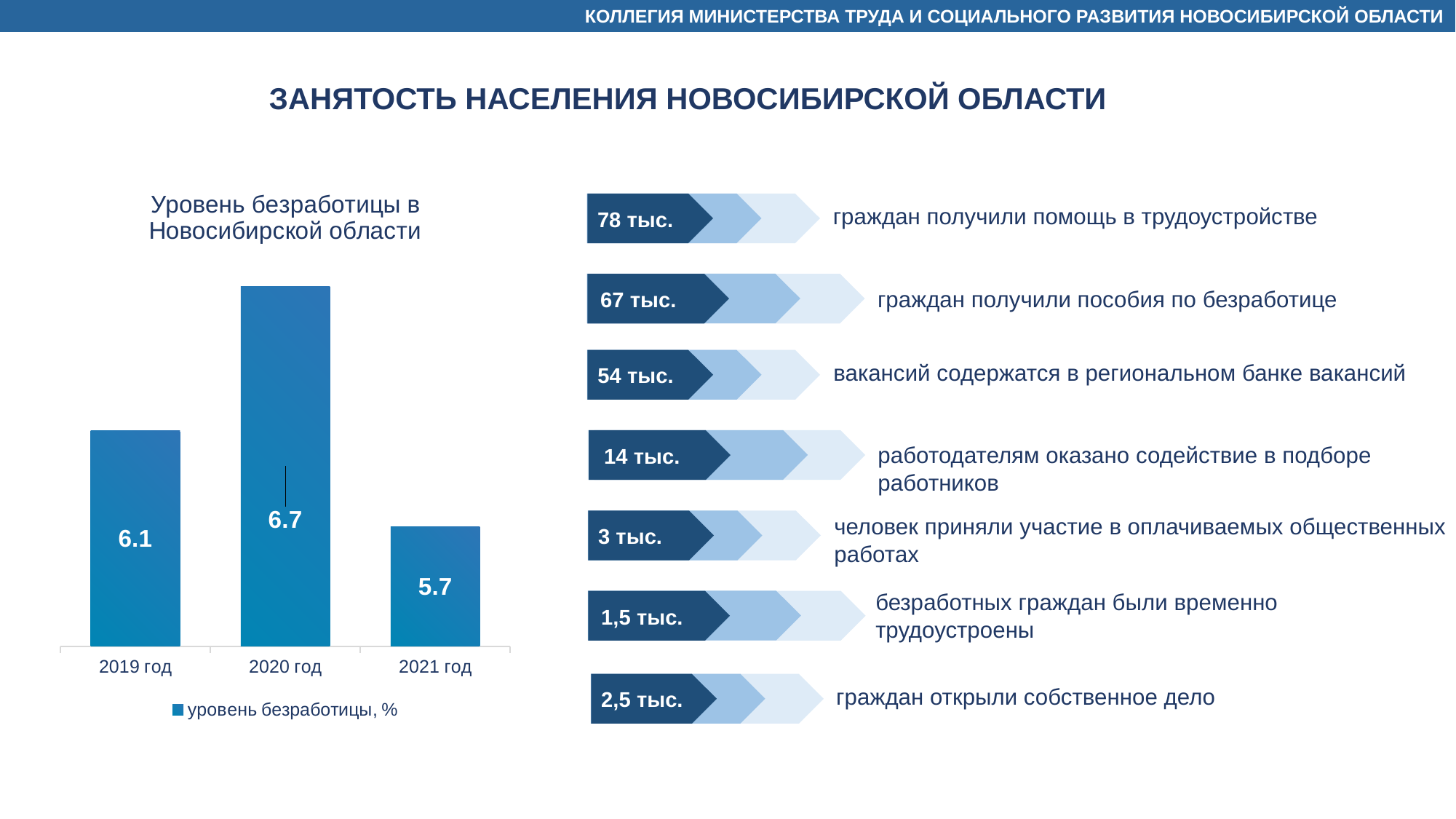
What is the unemployment rate shown for 2019 год? 6.1 What is the unemployment rate shown for 2021 год? 5.7 What is the legend entry of the chart? уровень безработицы, % Which year has the highest unemployment rate in the chart? 2020 год How many years are shown on the x axis of the chart? 3 What is the difference between the unemployment rate in 2020 год and 2021 год? 1.0 Which year has a higher unemployment rate, 2019 год or 2021 год? 2019 год How many series does the chart legend list? 1 Which year has the lowest unemployment rate in the chart? 2021 год What type of chart is used to show the unemployment rate? bar chart What is the difference between the unemployment rate in 2020 год and 2019 год? 0.6 What is the unemployment rate shown for 2020 год? 6.7